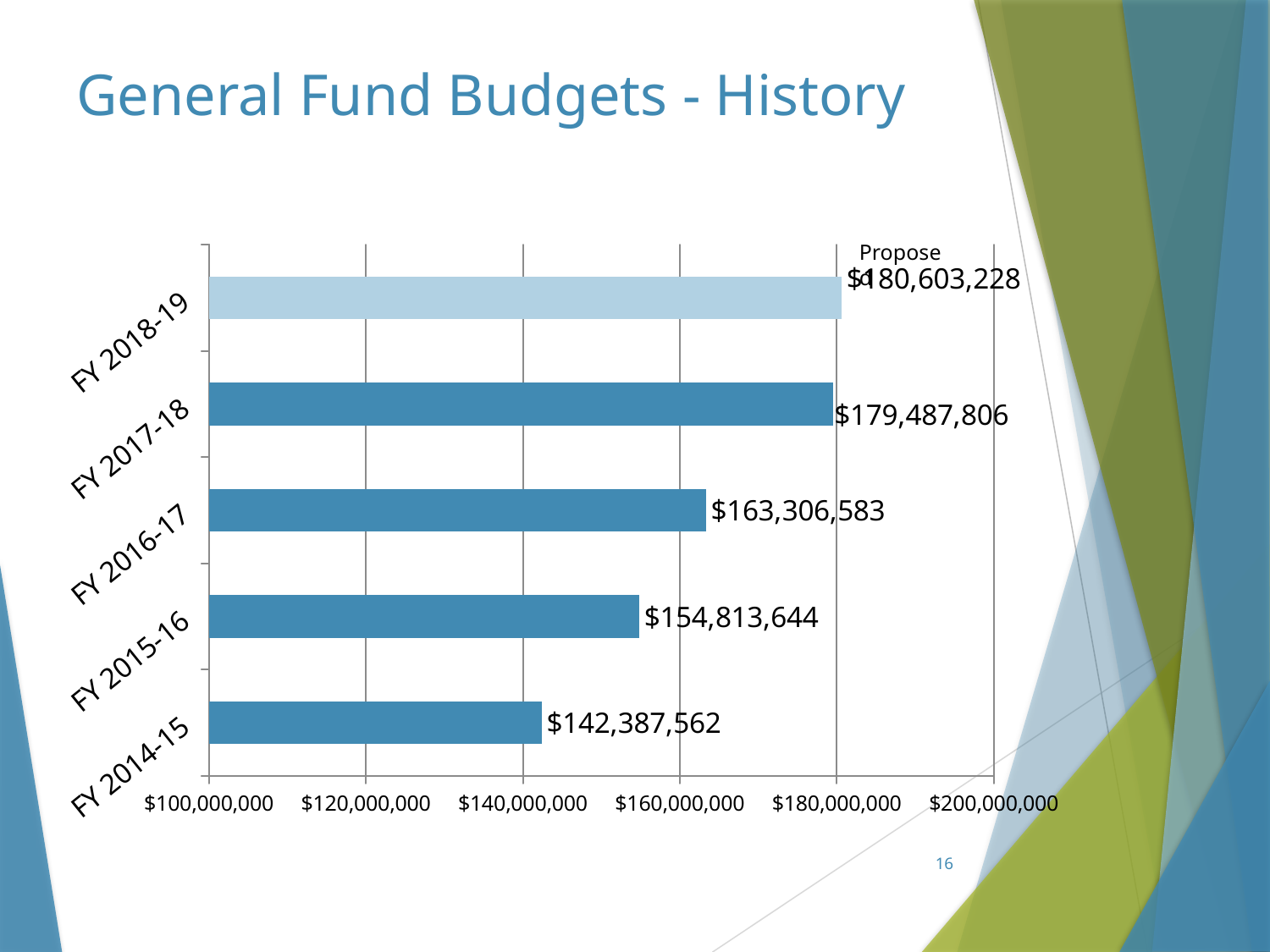
Is the value for FY 2015-16 greater or less than $160,000,000? less Which fiscal year has the lowest General Fund budget? FY 2014-15 What is the difference between the FY 2017-18 budget and the FY 2016-17 budget? $16,181,223 What is the difference between the FY 2015-16 budget and the FY 2014-15 budget? $12,426,082 Which fiscal year has the highest General Fund budget? FY 2018-19 What kind of chart is shown on the slide? Bar chart What is the value shown for FY 2016-17? $163,306,583 What is the General Fund budget value shown for FY 2014-15? $142,387,562 Which is larger, the budget for FY 2016-17 or for FY 2015-16? FY 2016-17 What is the value shown for FY 2017-18? $179,487,806 What is the proposed value shown for FY 2018-19? $180,603,228 How many fiscal years are shown in the chart? 5